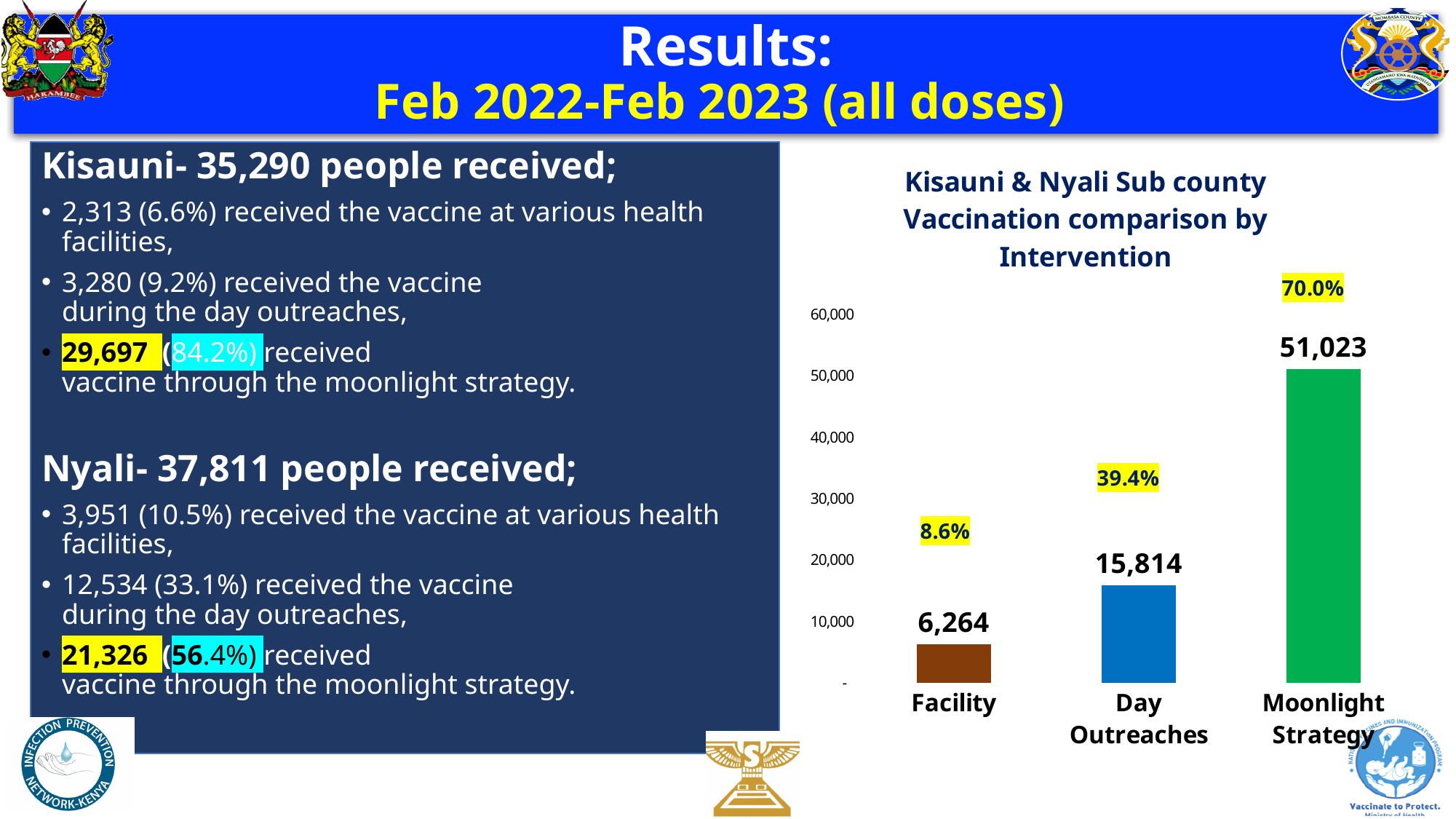
How many interventions are plotted in the chart? 3 Which intervention has the highest value in the chart? Moonlight Strategy What is the difference between the Moonlight Strategy value and the Day Outreaches value? 35,209 What is the value for Facility in the chart? 6,264 What percentage label is shown above the Facility bar? 8.6% What type of chart is shown on the slide? Bar chart What percentage label is shown above the Moonlight Strategy bar? 70.0% Which is larger, the value for Day Outreaches or the value for Facility? Day Outreaches What is the value for Day Outreaches in the chart? 15,814 Which intervention has the lowest value in the chart? Facility What is the value for Moonlight Strategy in the chart? 51,023 What is the title of the chart? Kisauni & Nyali Sub county Vaccination comparison by Intervention